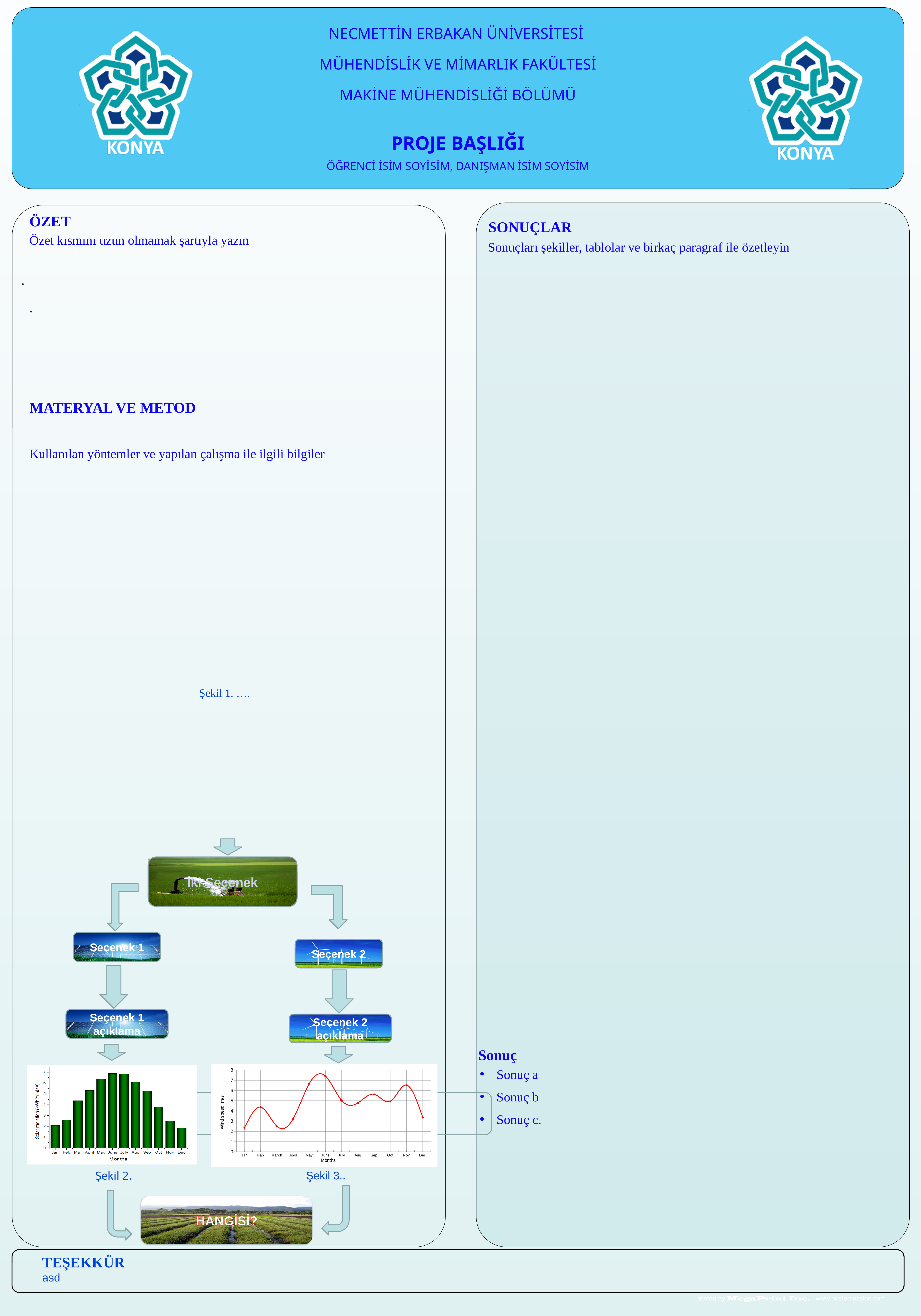
In Şekil 2 (the bar chart), how many months are shown on the x axis? 12 In Şekil 3 (the line chart), which is larger, the value for June or the value for Dec? June What kind of chart is Şekil 2 (the left chart)? bar chart What kind of chart is Şekil 3 (the right chart)? line chart In Şekil 3 (the line chart), which month has the highest wind speed? June In Şekil 3 (the line chart), is the value for June greater or less than 7? greater In Şekil 2 (the bar chart), which is larger, the value for May or the value for Feb? May What is the y-axis label of Şekil 3 (the line chart)? Wind speed, m/s In Şekil 3 (the line chart), how many months are shown on the x axis? 12 In Şekil 2 (the bar chart), do the values rise or fall from Jan to June? rise In Şekil 2 (the bar chart), is the value for Jan greater or less than 3? less In Şekil 2 (the bar chart), is the value for June greater or less than 6? greater